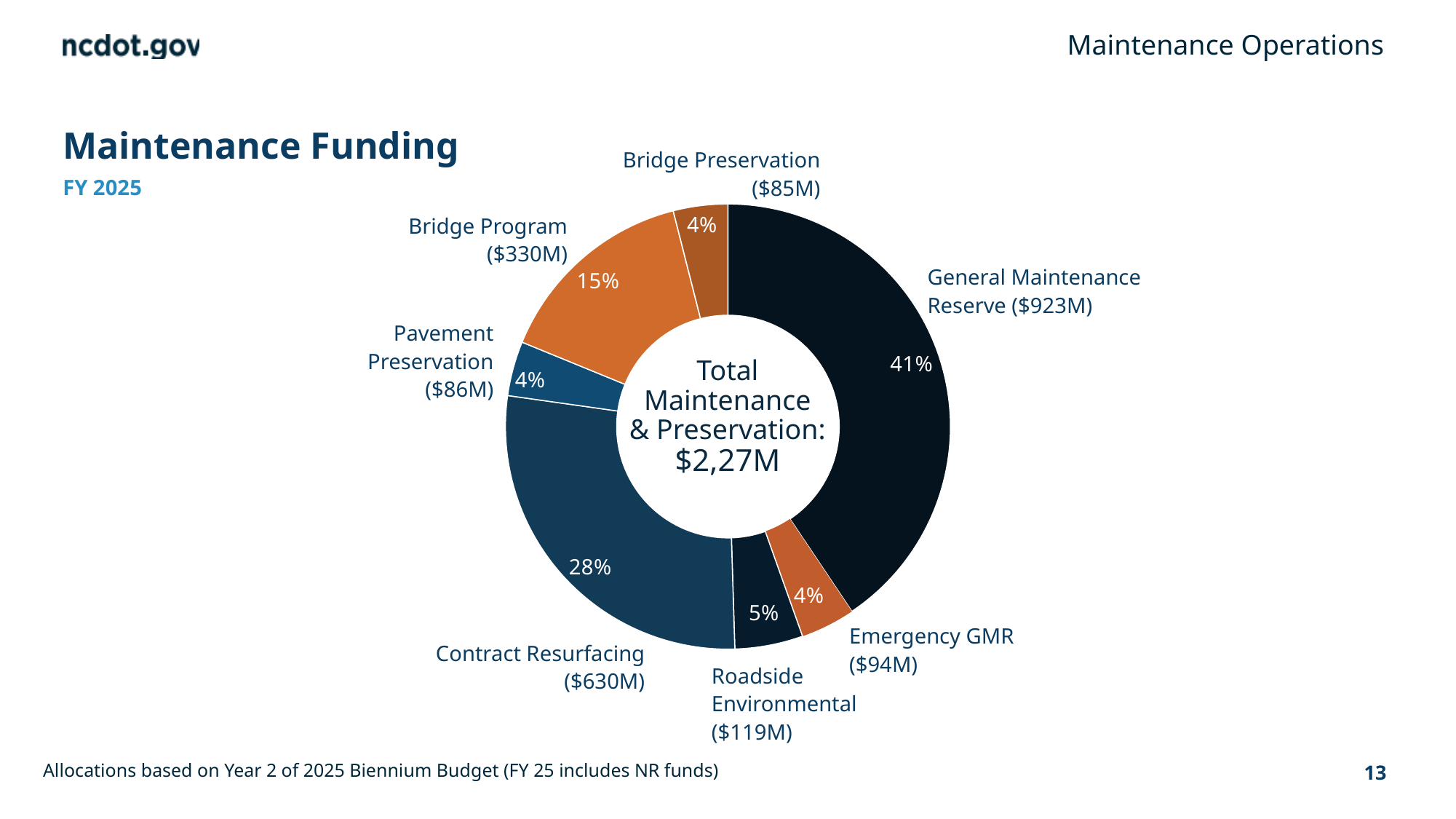
What kind of chart is shown on the slide? Pie chart (donut) Which category has the largest share of the chart? General Maintenance Reserve What percentage share does Bridge Program have? 15% What is the dollar amount for Roadside Environmental? $119M How many funding categories are shown in the chart? 7 What total is printed in the center of the chart? $2,27M What is the dollar amount for Contract Resurfacing? $630M What is the dollar amount for Bridge Program? $330M Which is larger, Bridge Program or Roadside Environmental? Bridge Program What percentage share does General Maintenance Reserve have? 41% What is the dollar amount for General Maintenance Reserve? $923M What is the difference in dollars between General Maintenance Reserve and Contract Resurfacing? $293M